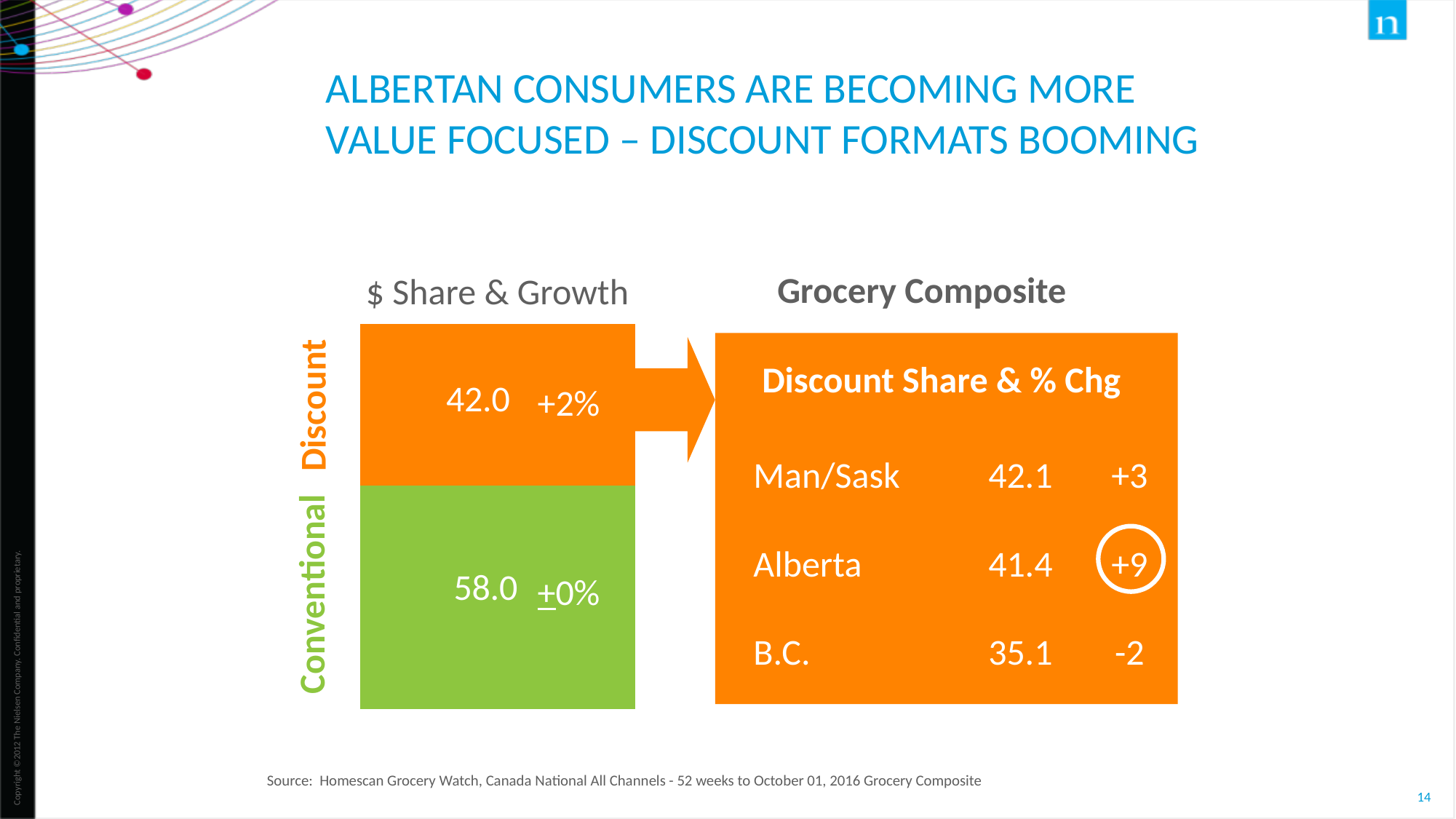
In the "$ Share & Growth" chart, which segment is larger, Discount or Conventional? Conventional In the "$ Share & Growth" chart, what is the value for Conventional? 58.0 In the "$ Share & Growth" chart, what is the difference between the Conventional and Discount values? 16.0 In the "$ Share & Growth" chart, what is the value for Discount? 42.0 In the "$ Share & Growth" chart, what growth is shown for Discount? +2% In the "$ Share & Growth" chart, what is the total of the stacked bar? 100.0 What kind of chart is the "$ Share & Growth" chart? Stacked bar chart In the "Grocery Composite" panel, what is the Discount Share for Alberta? 41.4 In the "$ Share & Growth" chart, what growth is shown for Conventional? ±0% In the "Grocery Composite" panel, which region has the highest % Chg? Alberta How many segments does the "$ Share & Growth" stacked bar have? 2 In the "$ Share & Growth" chart, what colour is the Discount segment? Orange